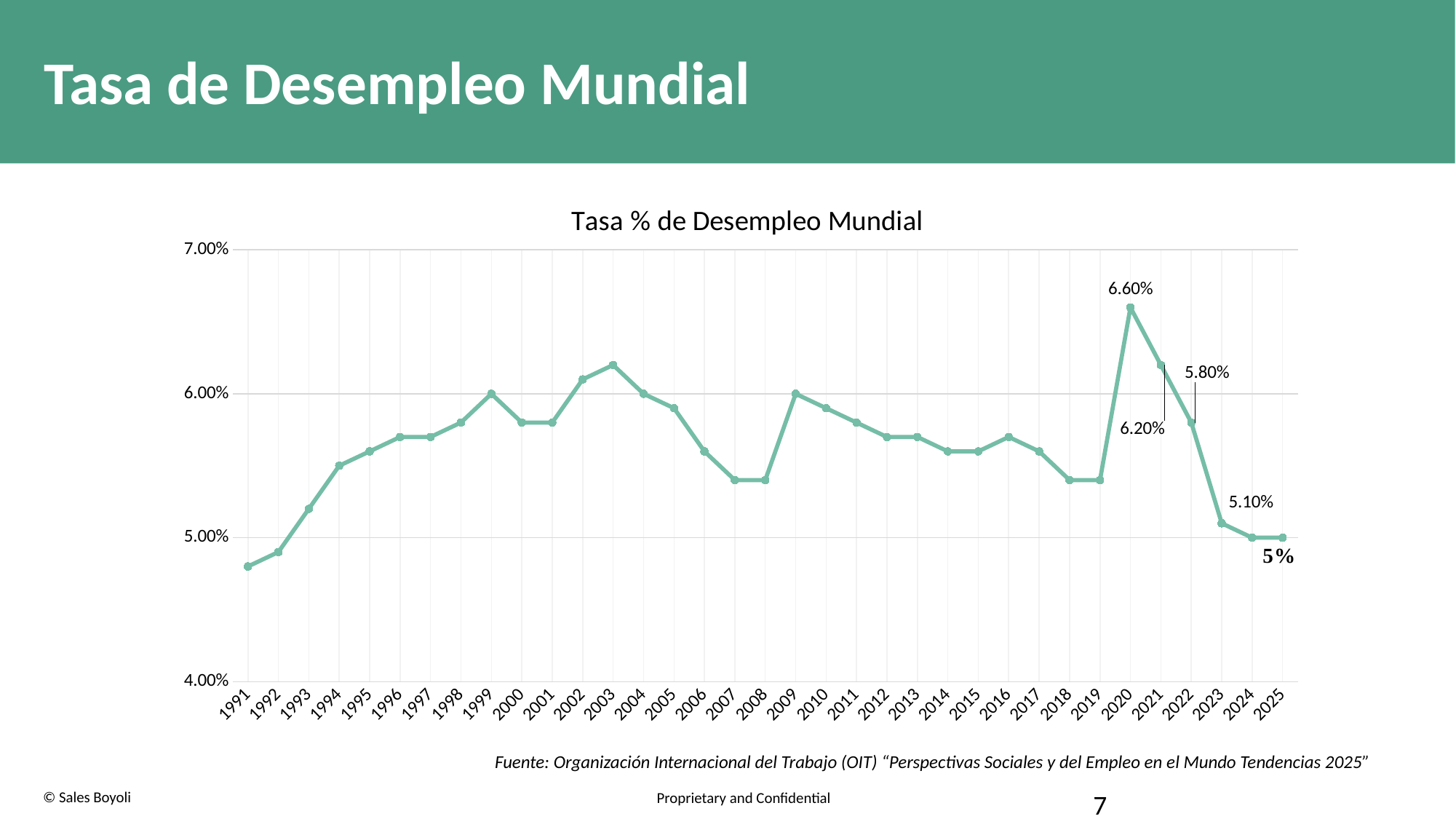
What is the value for 2022? 5.80% What kind of chart is shown? line chart Do the values rise or fall from 2020 to 2023? fall What is the value for 2025? 5% What is the value for 2023? 5.10% Is the value for 1991 greater or less than 5.00%? less How many years are plotted on the x axis? 35 What is the value for 2020? 6.60% Which year has the highest unemployment rate? 2020 Which year has the lowest unemployment rate? 1991 Which is larger, the value for 2021 or the value for 2022? 2021 What is the difference between the values for 2020 and 2023? 1.50%